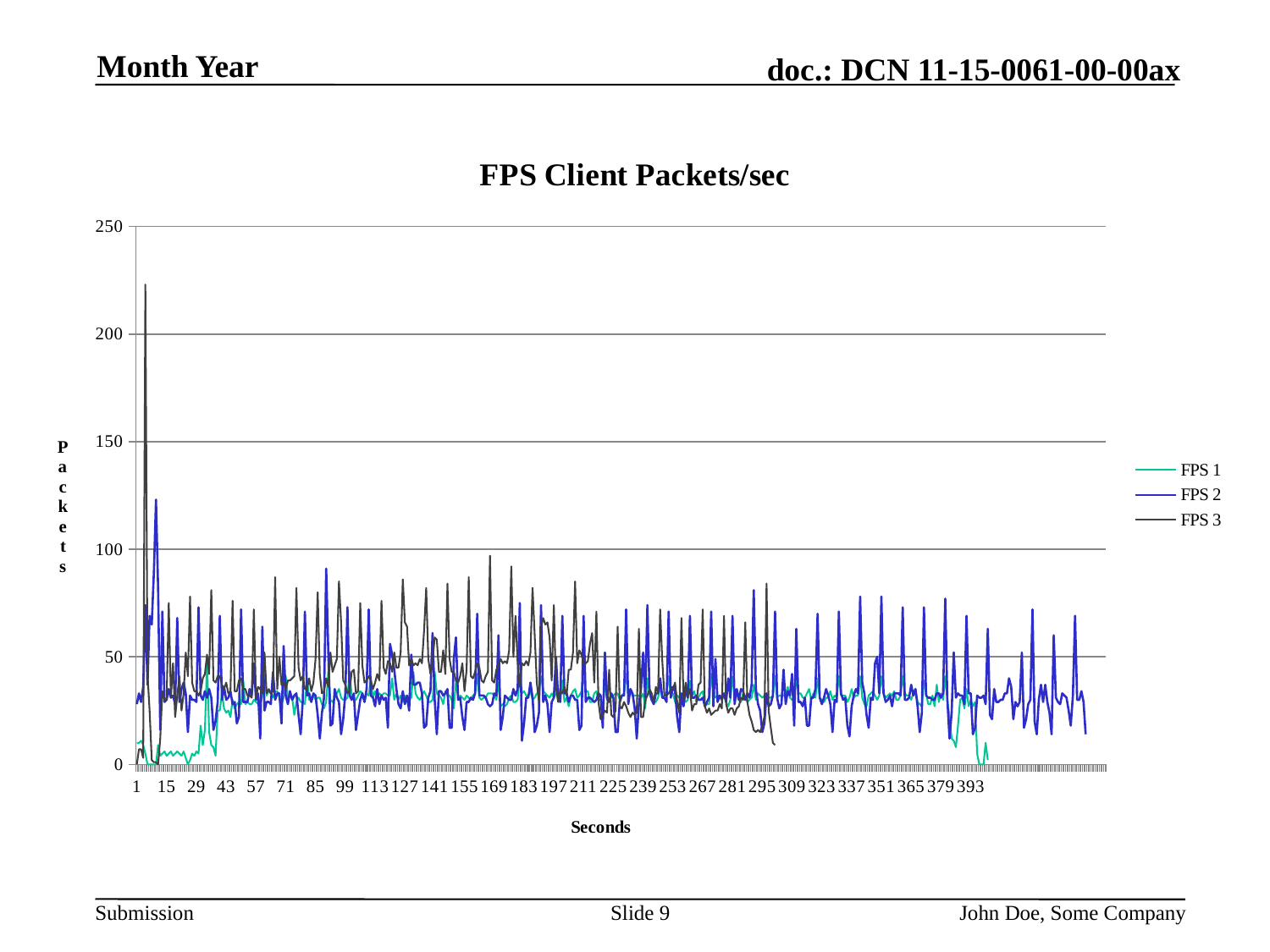
What is the title of the chart? FPS Client Packets/sec Which series stops earliest along the x axis (ends around second 300)? FPS 3 Which series reaches the highest value on the chart? FPS 3 Which series has the lowest peak value? FPS 1 Is the highest value of FPS 2 greater or less than 150? less Which series has the higher peak, FPS 2 or FPS 3? FPS 3 How many series does the legend list? 3 Is the highest value of FPS 1 greater or less than 100? less Is the highest value of FPS 2 greater or less than 100? greater What kind of chart is shown on the slide? line chart What are the series names listed in the legend? FPS 1, FPS 2, FPS 3